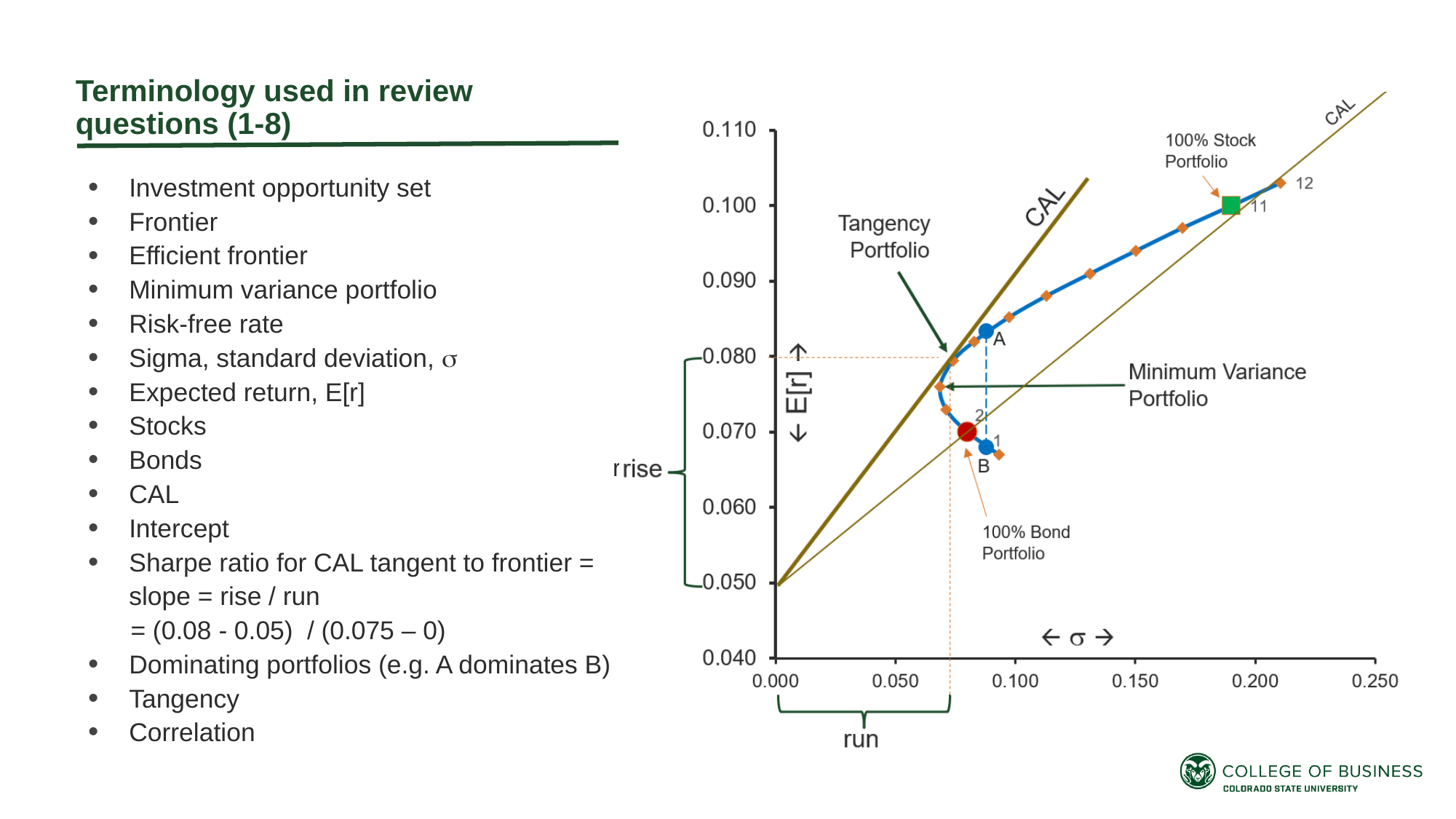
What is the label on the y axis of the chart? E[r] What is the expected return E[r] of the tangency portfolio? 0.080 What is the expected return E[r] of the 100% Stock Portfolio? 0.100 What is the expected return E[r] of the 100% Bond Portfolio (point B)? 0.070 Is the σ value for the Minimum Variance Portfolio greater or less than 0.100? less At what E[r] value does the CAL intercept the y axis? 0.050 Is the E[r] value for point A greater or less than 0.080? greater What is the label on the x axis of the chart? σ Is the σ value for the 100% Stock Portfolio greater or less than 0.150? greater Which labeled point on the frontier has the highest expected return E[r]? 12 Which of points A and B has the higher expected return E[r]? A What kind of chart is shown on the slide? line chart